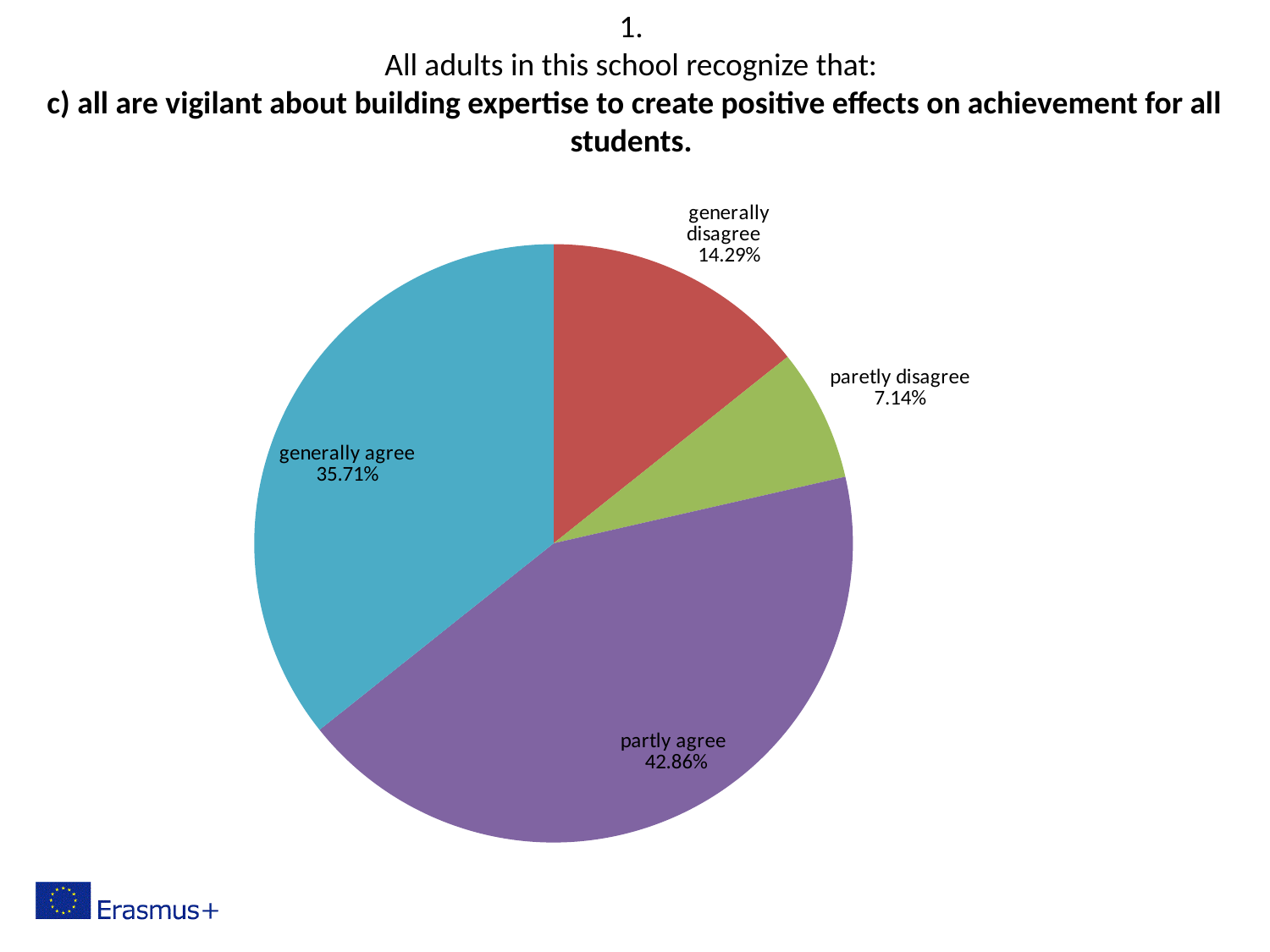
What share of the pie is labelled "paretly disagree"? 7.14% How many slices does the pie chart have? 4 Which category has the largest slice of the pie? partly agree What share of the pie is labelled "partly agree"? 42.86% What share of the pie is labelled "generally disagree"? 14.29% What colour is the "partly agree" slice? purple What share of the pie is labelled "generally agree"? 35.71% Which is larger, the share for "generally agree" or the share for "generally disagree"? generally agree Which category has the smallest slice of the pie? paretly disagree What is the difference in percentage points between "partly agree" and "generally agree"? 7.15 What is the difference in percentage points between "generally disagree" and "paretly disagree"? 7.15 What kind of chart is shown on the slide? pie chart